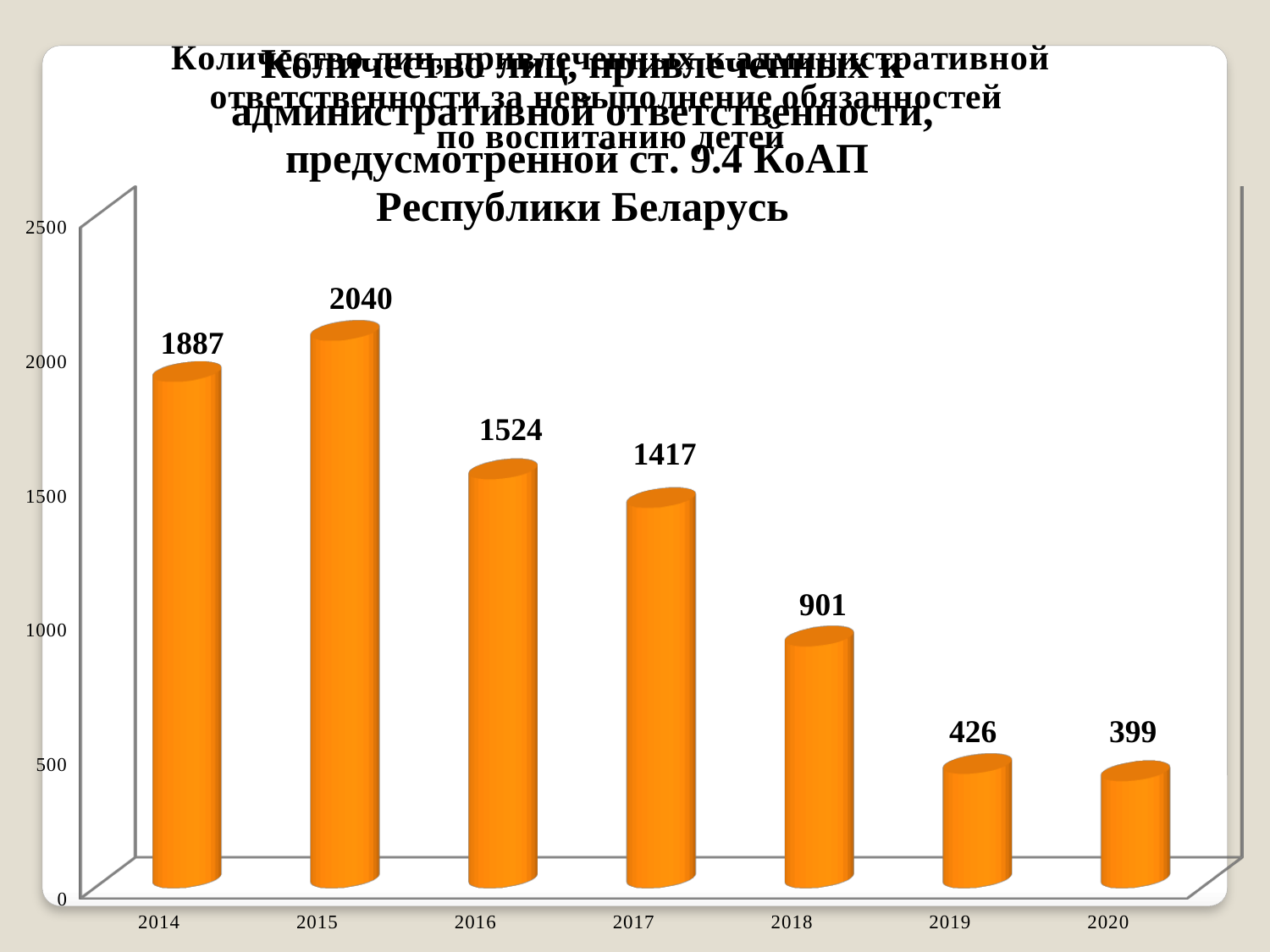
Which year has the lowest value? 2020 Which year has the highest value? 2015 What kind of chart is shown on the slide? bar chart How many years are shown on the x axis? 7 Which is larger, the value for 2018 or the value for 2019? 2018 Is the value for 2016 greater or less than 1500? greater What is the value for 2020? 399 What is the value for 2018? 901 Do the values generally rise or fall from 2015 to 2020? fall What is the difference between the values for 2015 and 2014? 153 What is the difference between the values for 2016 and 2017? 107 What is the value for 2014? 1887